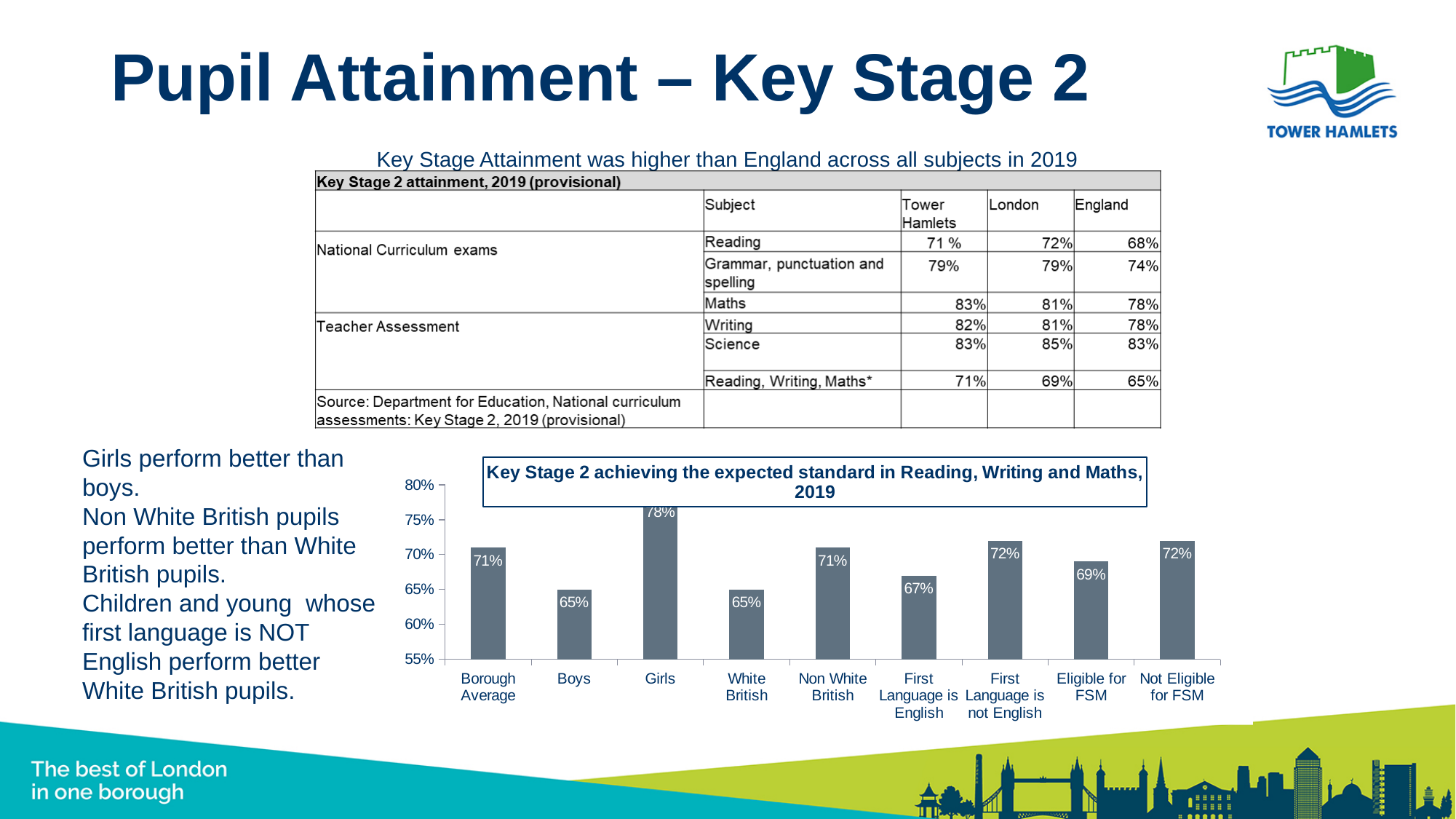
What is the value for Girls in the chart? 78% What is the value for Eligible for FSM in the chart? 69% What is the title of the chart? Key Stage 2 achieving the expected standard in Reading, Writing and Maths, 2019 What is the value for Boys in the chart? 65% Which category has the highest value in the chart? Girls What is the difference between the values for Girls and Boys? 13% What is the value for First Language is English in the chart? 67% Which is larger, the value for First Language is not English or First Language is English? First Language is not English How many categories are shown in the chart? 9 What kind of chart is shown on the slide? Bar chart What is the difference between the values for Non White British and White British? 6% Which is larger, the value for Not Eligible for FSM or Eligible for FSM? Not Eligible for FSM